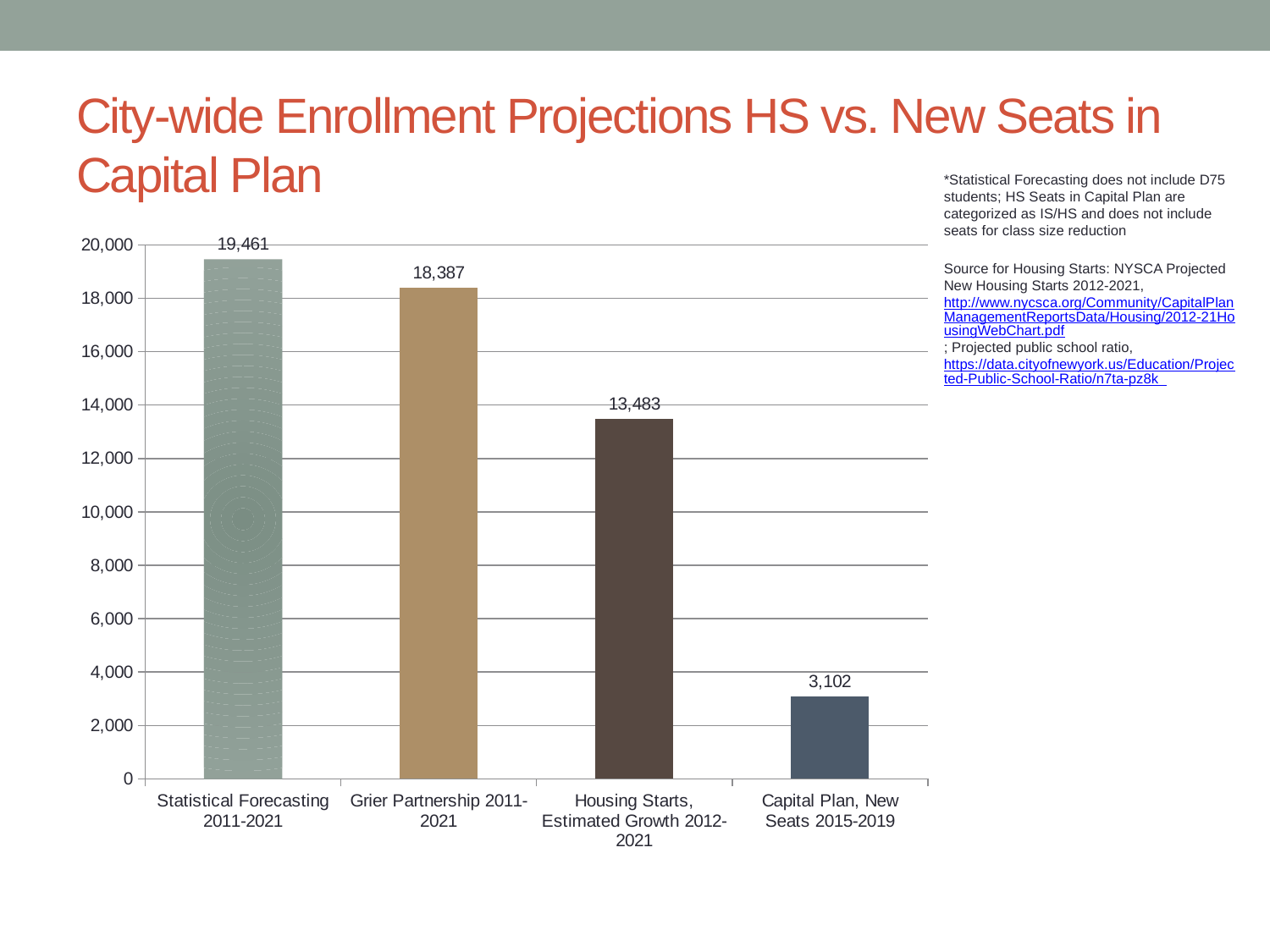
Which category has the highest value? Statistical Forecasting 2011-2021 What is the value for Housing Starts, Estimated Growth 2012-2021? 13,483 What is the value for Capital Plan, New Seats 2015-2019? 3,102 Which category has the lowest value? Capital Plan, New Seats 2015-2019 What is the value for Grier Partnership 2011-2021? 18,387 What kind of chart is shown on the slide? bar chart Is the value for Capital Plan, New Seats 2015-2019 greater or less than 4,000? less How many categories are shown on the chart? 4 What is the difference between the Grier Partnership 2011-2021 value and the Housing Starts, Estimated Growth 2012-2021 value? 4,904 Which is larger, the value for Grier Partnership 2011-2021 or the value for Housing Starts, Estimated Growth 2012-2021? Grier Partnership 2011-2021 What is the value for Statistical Forecasting 2011-2021? 19,461 What is the difference between the Statistical Forecasting 2011-2021 value and the Capital Plan, New Seats 2015-2019 value? 16,359